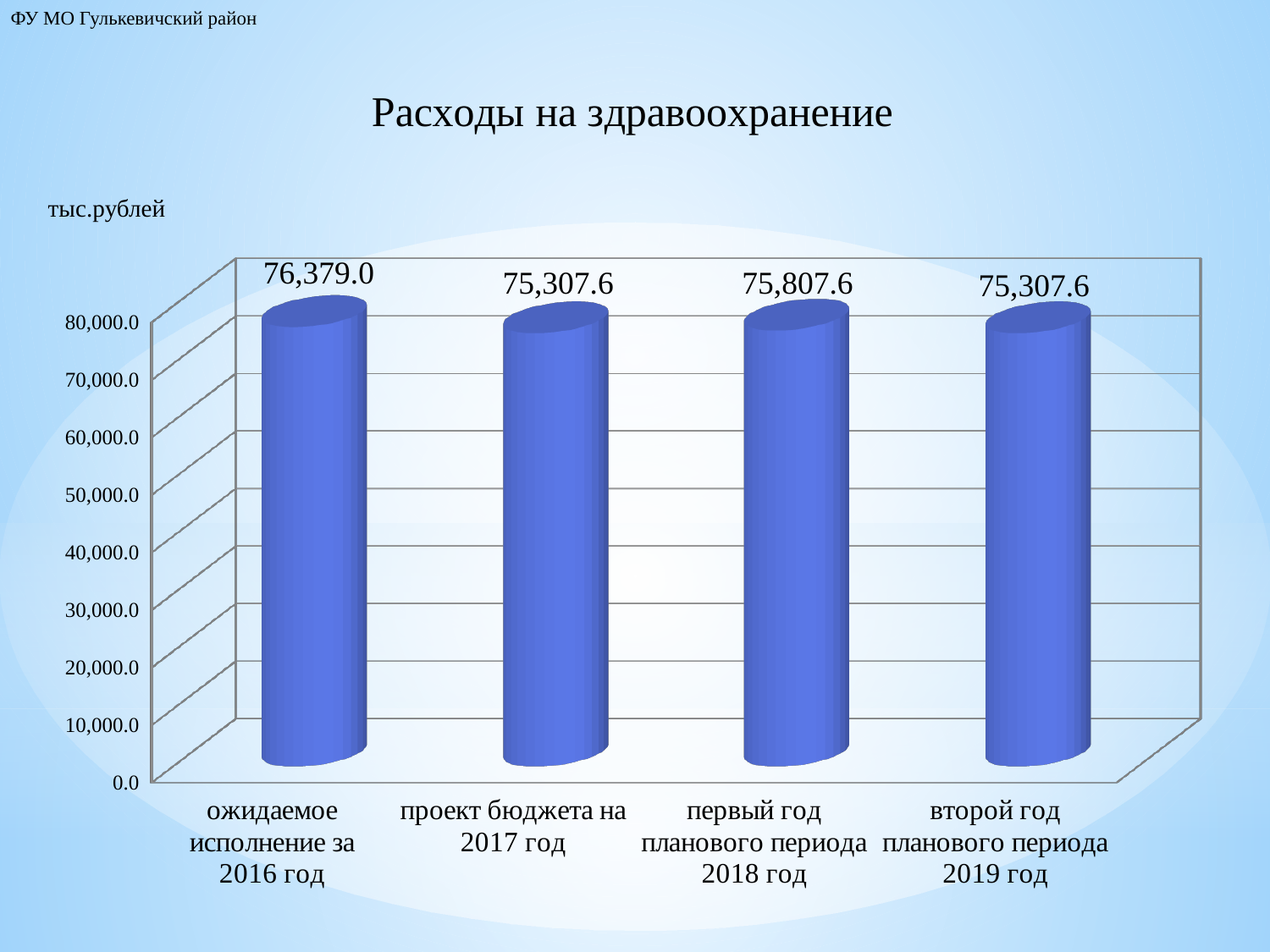
Is the value for 'ожидаемое исполнение за 2016 год' greater or less than 80,000.0? less Which is larger: the value for 2018 (первый год планового периода) or the value for 2017 (проект бюджета)? 2018 (первый год планового периода) How many categories are shown on the chart? 4 What is the difference between the value for 2018 (первый год планового периода) and the value for 2019 (второй год планового периода)? 500.0 What is the value for 'второй год планового периода 2019 год'? 75,307.6 What is the value for 'проект бюджета на 2017 год'? 75,307.6 Which category has the highest value? ожидаемое исполнение за 2016 год What kind of chart is shown on the slide? bar chart What is the value for 'ожидаемое исполнение за 2016 год'? 76,379.0 What is the title of the chart? Расходы на здравоохранение What is the value for 'первый год планового периода 2018 год'? 75,807.6 What is the difference between the value for 2016 (ожидаемое исполнение) and the value for 2017 (проект бюджета)? 1,071.4